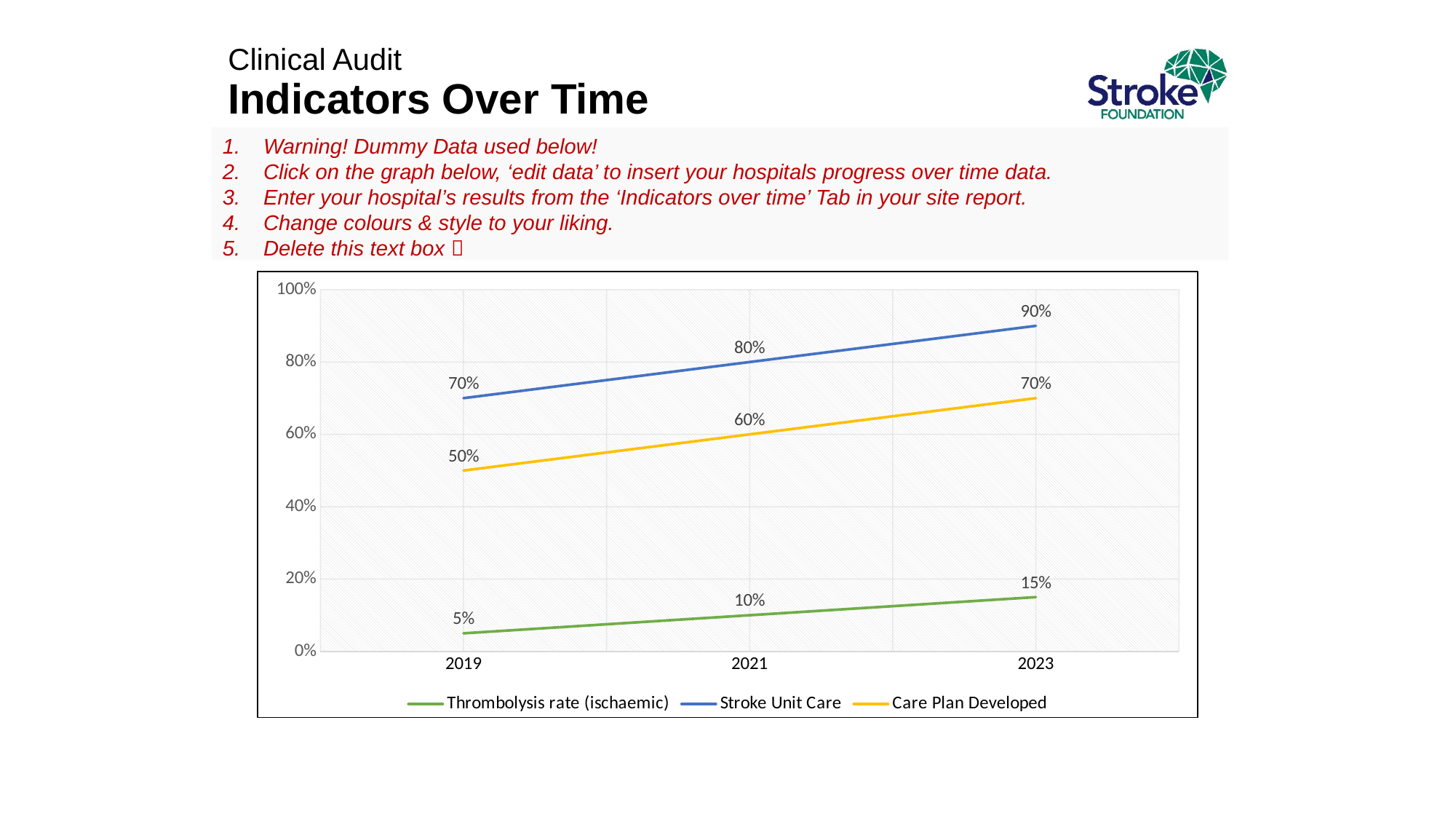
By how much did the Thrombolysis rate (ischaemic) increase from 2019 to 2023? 10% How many series does the legend list? 3 What is the difference between the Stroke Unit Care value and the Care Plan Developed value in 2019? 20% What kind of chart is shown on the slide? Line chart How many years are shown on the x axis? 3 Which is larger in 2021: Stroke Unit Care or Care Plan Developed? Stroke Unit Care What is the Thrombolysis rate (ischaemic) value for 2019? 5% Does the Care Plan Developed series rise or fall from 2019 to 2023? Rise In which year is the Stroke Unit Care value highest? 2023 What is the Care Plan Developed value for 2023? 70% What is the Stroke Unit Care value for 2021? 80% In which year is the Care Plan Developed value lowest? 2019